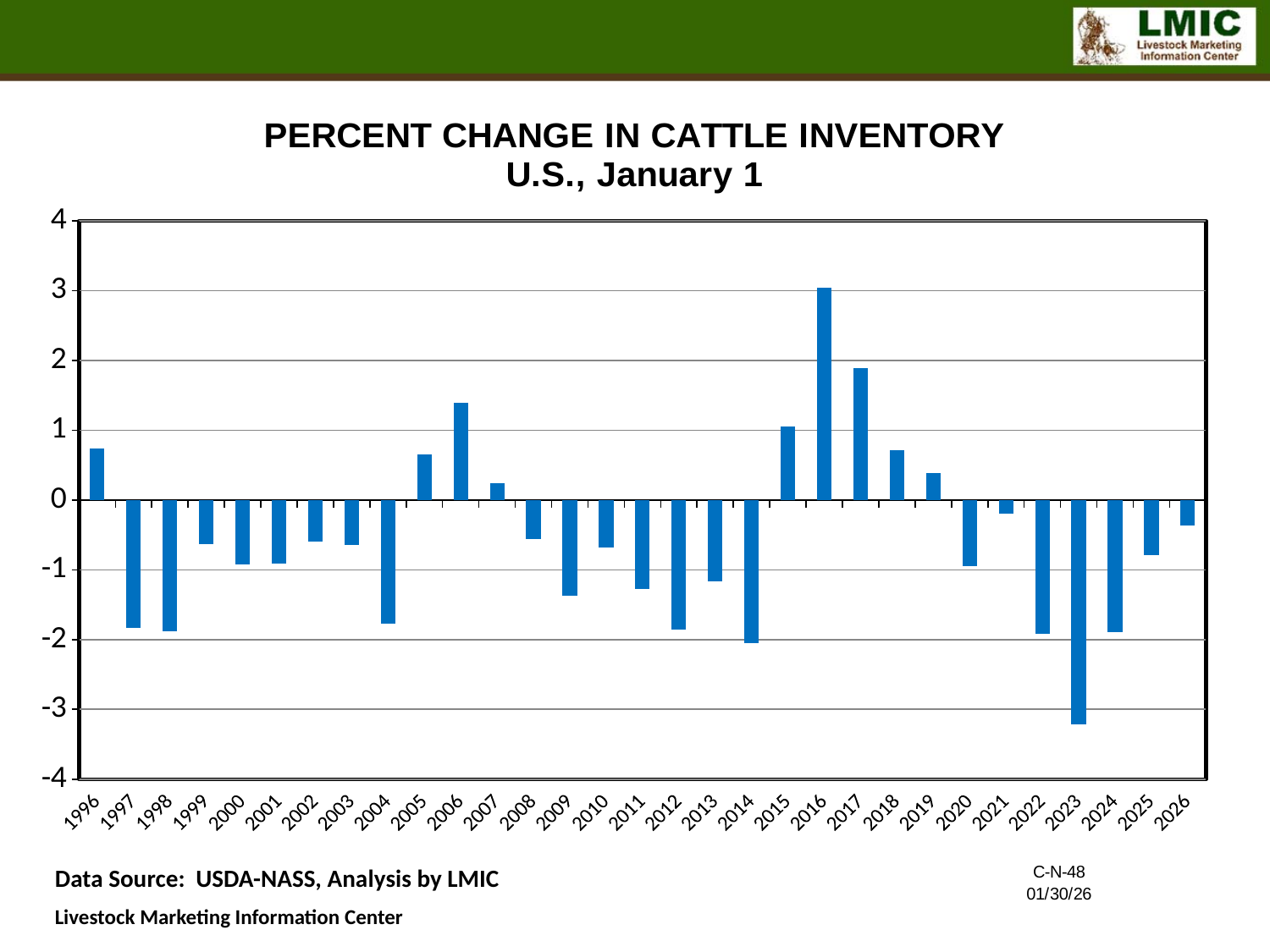
Is the value for 2012 greater or less than -1? less Which year has the lowest percent change in cattle inventory? 2023 Is the value for 2016 greater or less than 2? greater Is the value for 2017 greater or less than 1? greater Which year has the larger percent change, 2016 or 2017? 2016 What kind of chart is shown on the slide? bar chart What is the title of the chart? PERCENT CHANGE IN CATTLE INVENTORY U.S., January 1 Do the values rise or fall from 2016 to 2019? fall How many years are plotted on the x axis? 31 Which year has the highest percent change in cattle inventory? 2016